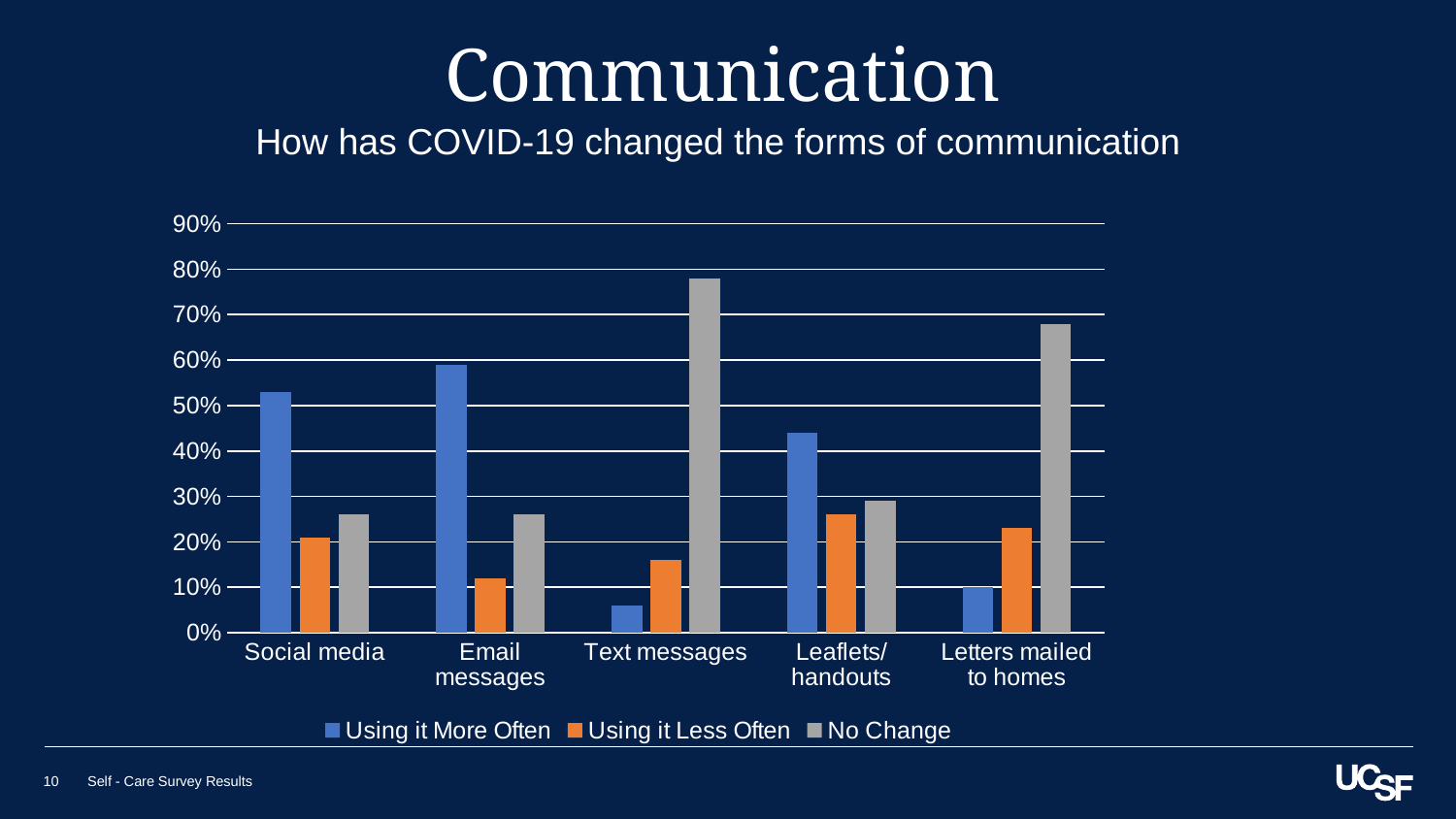
For Letters mailed to homes, which is larger: "Using it More Often" or "No Change"? No Change How many series does the legend list? 3 Is the "Using it More Often" value for Social media greater or less than 50%? greater Is the "Using it Less Often" value for Email messages greater or less than 20%? less How many communication categories are shown on the x axis? 5 Which category has the highest value for "No Change"? Text messages Which category has the highest value for "Using it More Often"? Email messages Which category has the lowest value for "Using it More Often"? Text messages Is the "No Change" value for Text messages greater or less than 70%? greater Which series is shown in orange in the legend? Using it Less Often What kind of chart is shown on the slide? bar chart Which category has the lowest value for "Using it Less Often"? Email messages